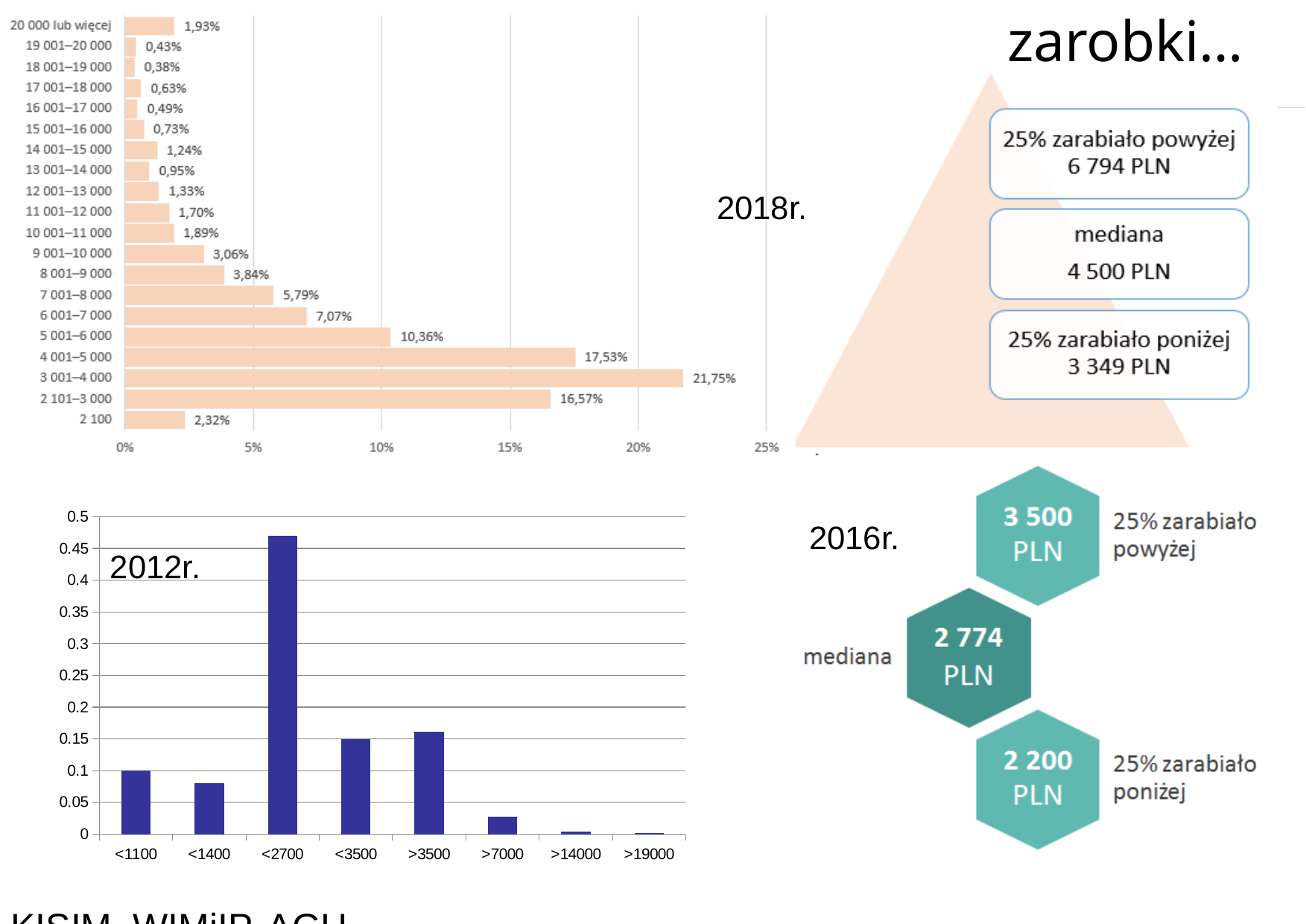
In the 2012 bar chart, which category has the highest value? <2700 In the 2012 bar chart, what is the value for the <1100 category? 0.1 In the 2018 horizontal bar chart, what is the value for the 5 001–6 000 category? 10,36% In the 2018 horizontal bar chart, which category has the highest value? 3 001–4 000 In the 2018 horizontal bar chart, what is the value for the 3 001–4 000 category? 21,75% In the 2018 horizontal bar chart, how many categories are shown? 20 In the 2018 horizontal bar chart, which is larger: the value for 7 001–8 000 or the value for 6 001–7 000? 6 001–7 000 In the 2012 bar chart, how many categories are shown on the x axis? 8 In the 2018 horizontal bar chart, which category has the lowest value? 18 001–19 000 In the 2018 horizontal bar chart, what is the difference between the values for 4 001–5 000 and 2 101–3 000? 0,96% In the 2012 bar chart, is the value for <2700 greater or less than 0.45? greater In the 2012 bar chart, what is the value for the <3500 category? 0.15